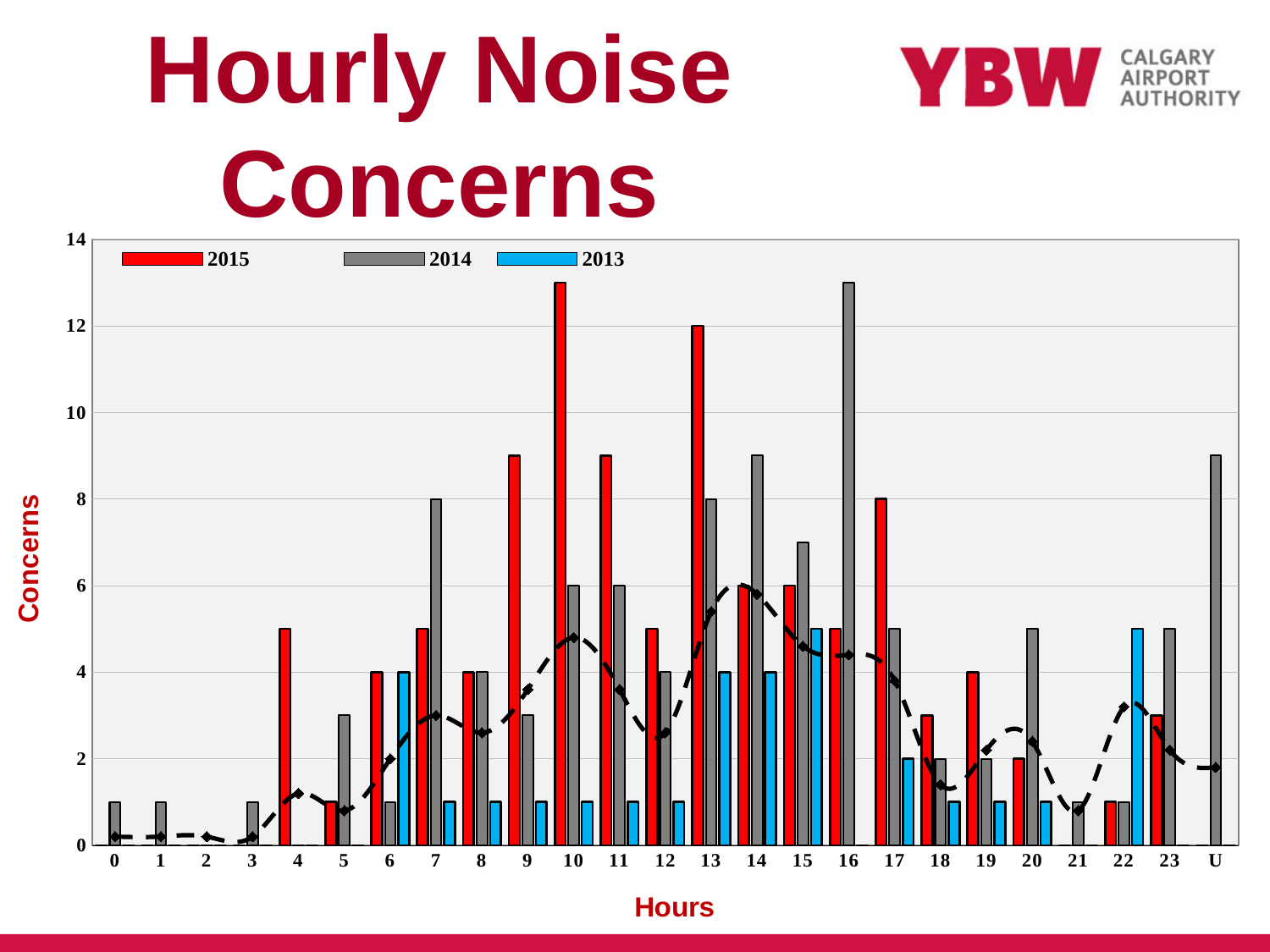
How many series does the legend list? 3 Is the value for 2014 at category U greater or less than 8? greater What kind of chart is shown on the slide? combination bar and line chart At which hour is the 2015 value highest? 10 At which hour is the 2014 value highest? 16 Is the value for 2015 at hour 10 greater or less than 12? greater What is the value for 2015 at hour 13? 12 What is the difference between the 2015 and 2014 values at hour 13? 4 What is the value for 2014 at hour 7? 8 At hour 16, which series has the larger value, 2015 or 2014? 2014 How many hour categories are shown on the x axis? 25 What is the value for 2013 at hour 6? 4